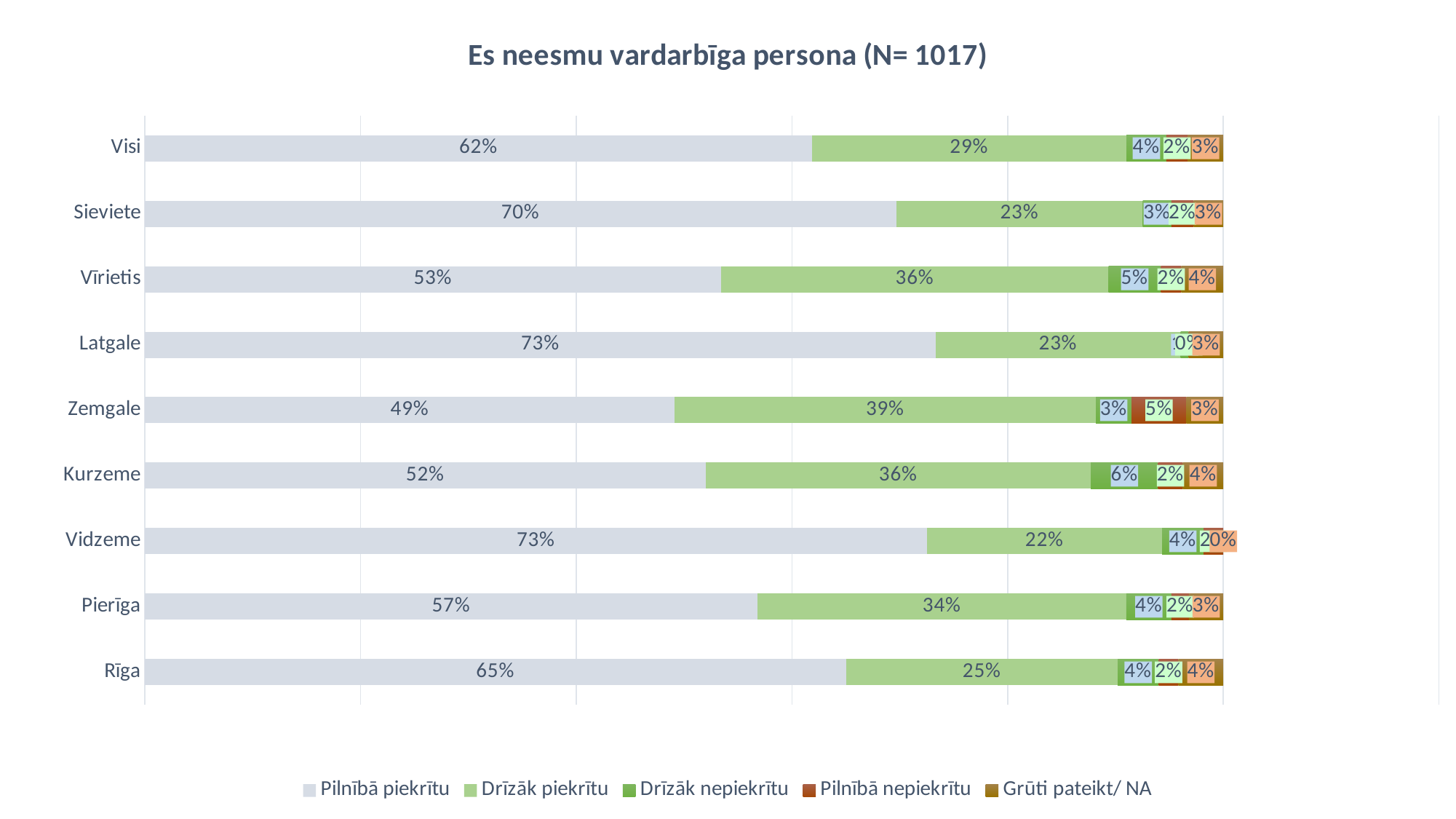
Which category has the highest 'Drīzāk piekrītu' value? Zemgale What is the difference between the 'Pilnībā piekrītu' values for Sieviete and Vīrietis? 17 percentage points Which has a larger 'Pilnībā piekrītu' value, Rīga or Pierīga? Rīga Which category has the lowest 'Drīzāk piekrītu' value? Vidzeme What is the 'Drīzāk piekrītu' value for Vīrietis? 36% What is the 'Pilnībā piekrītu' value for Sieviete? 70% What is the 'Pilnībā piekrītu' value for Visi? 62% What is the title of the chart? Es neesmu vardarbīga persona (N= 1017) Which category has the lowest 'Pilnībā piekrītu' value? Zemgale How many categories (bars) are shown on the chart? 9 How many series does the legend list? 5 What kind of chart is shown on the slide? Stacked bar chart